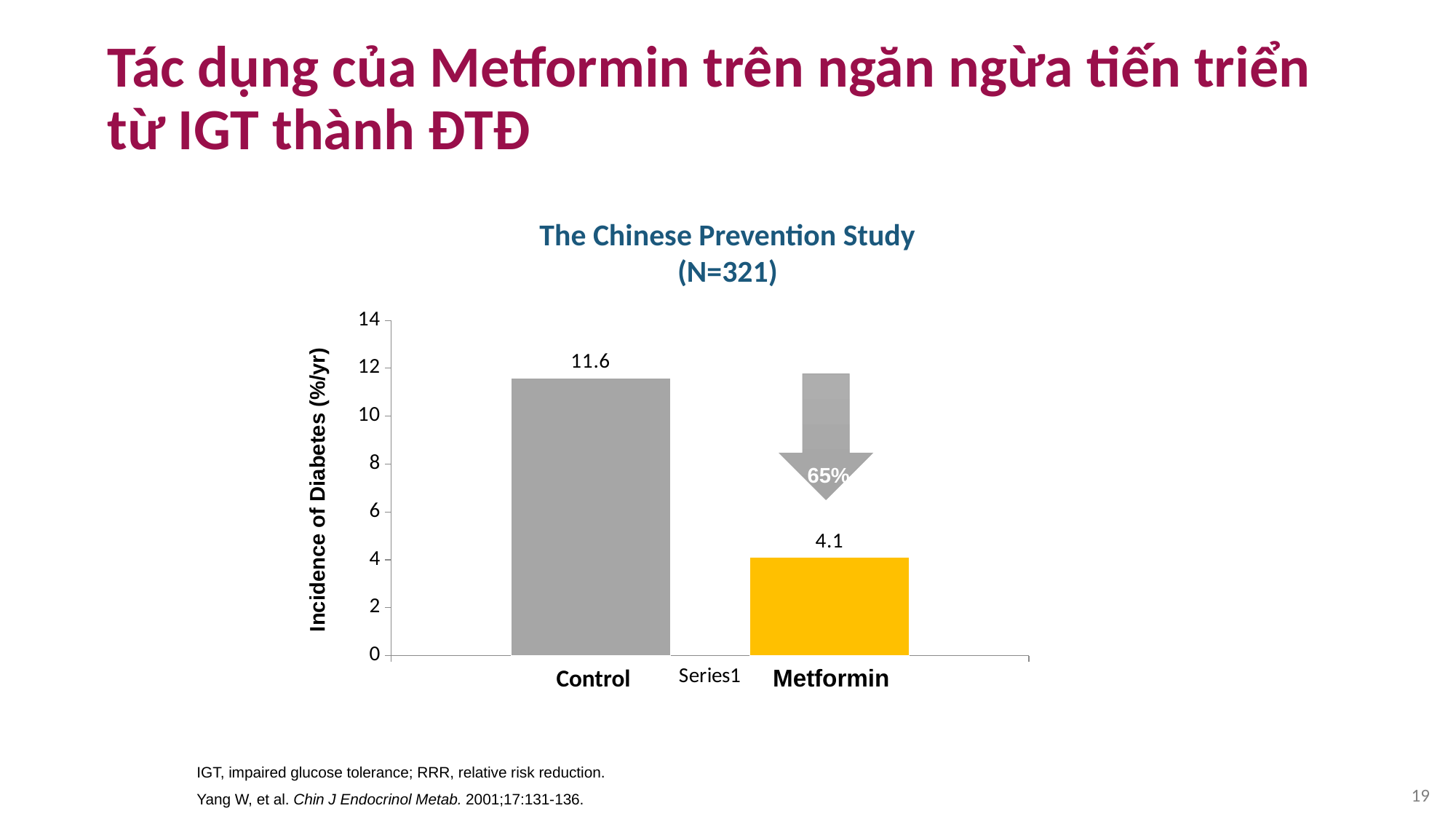
Is the value for Metformin greater or less than 6? less What kind of chart is shown on the slide? Bar chart What is the title of the chart? The Chinese Prevention Study (N=321) What is the label of the y axis? Incidence of Diabetes (%/yr) Which group has the lower incidence of diabetes? Metformin What is the incidence of diabetes for the Control group? 11.6 How many bars are plotted in the chart? 2 Is the incidence of diabetes greater for Control or for Metformin? Control Which group has the higher incidence of diabetes? Control Is the value for Control greater or less than 10? greater What is the incidence of diabetes for the Metformin group? 4.1 What is the difference in incidence of diabetes between the Control and Metformin groups? 7.5